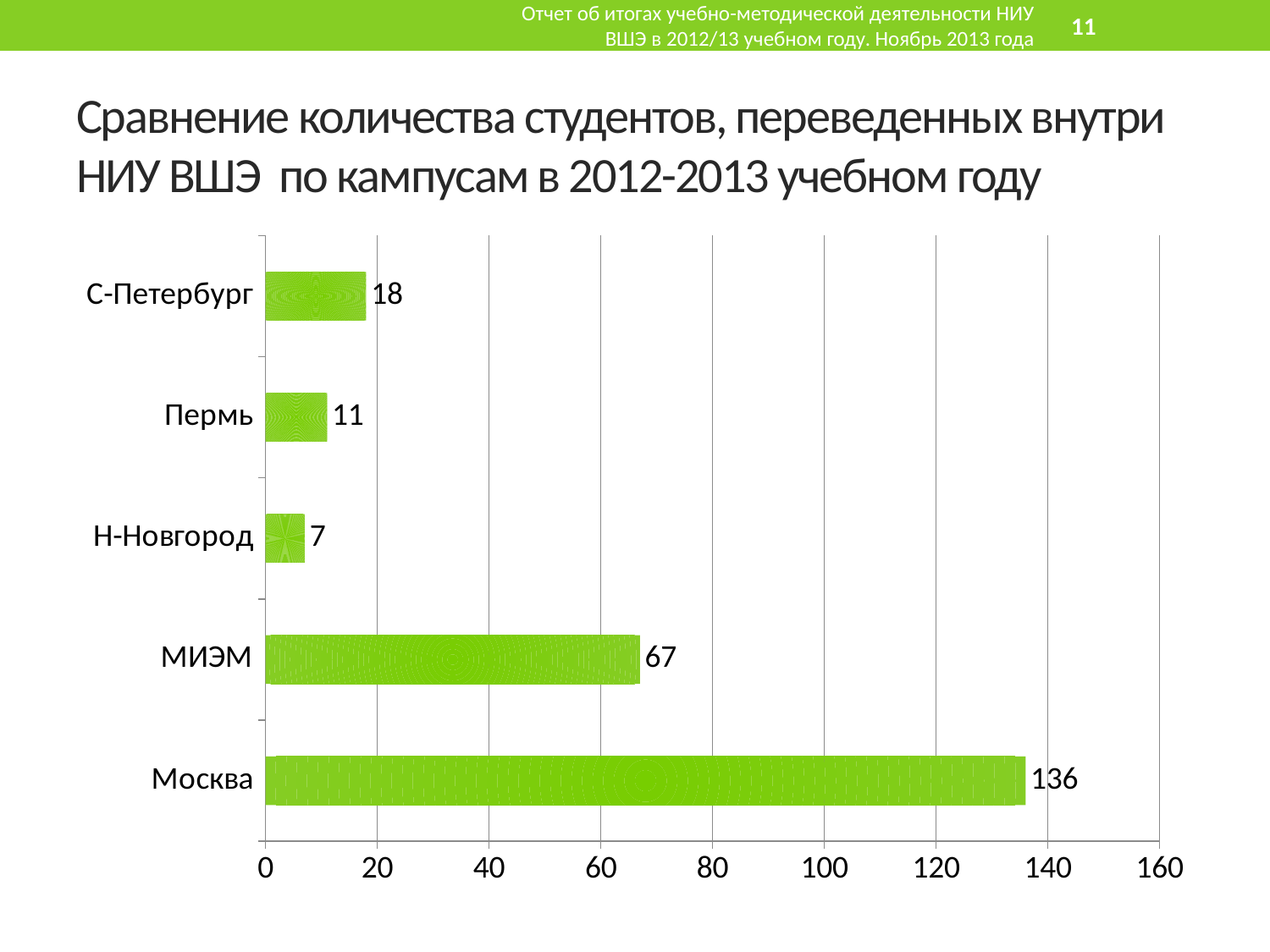
Is the value for Москва greater or less than 120? greater What is the value for С-Петербург? 18 What kind of chart is shown on the slide? bar chart What is the value for МИЭМ? 67 What is the value for Пермь? 11 Which is larger, the value for С-Петербург or the value for Пермь? С-Петербург Which campus has the highest value? Москва What is the difference between the values for Москва and МИЭМ? 69 Which campus has the lowest value? Н-Новгород What is the value for Москва? 136 What is the value for Н-Новгород? 7 How many campuses are shown in the chart? 5